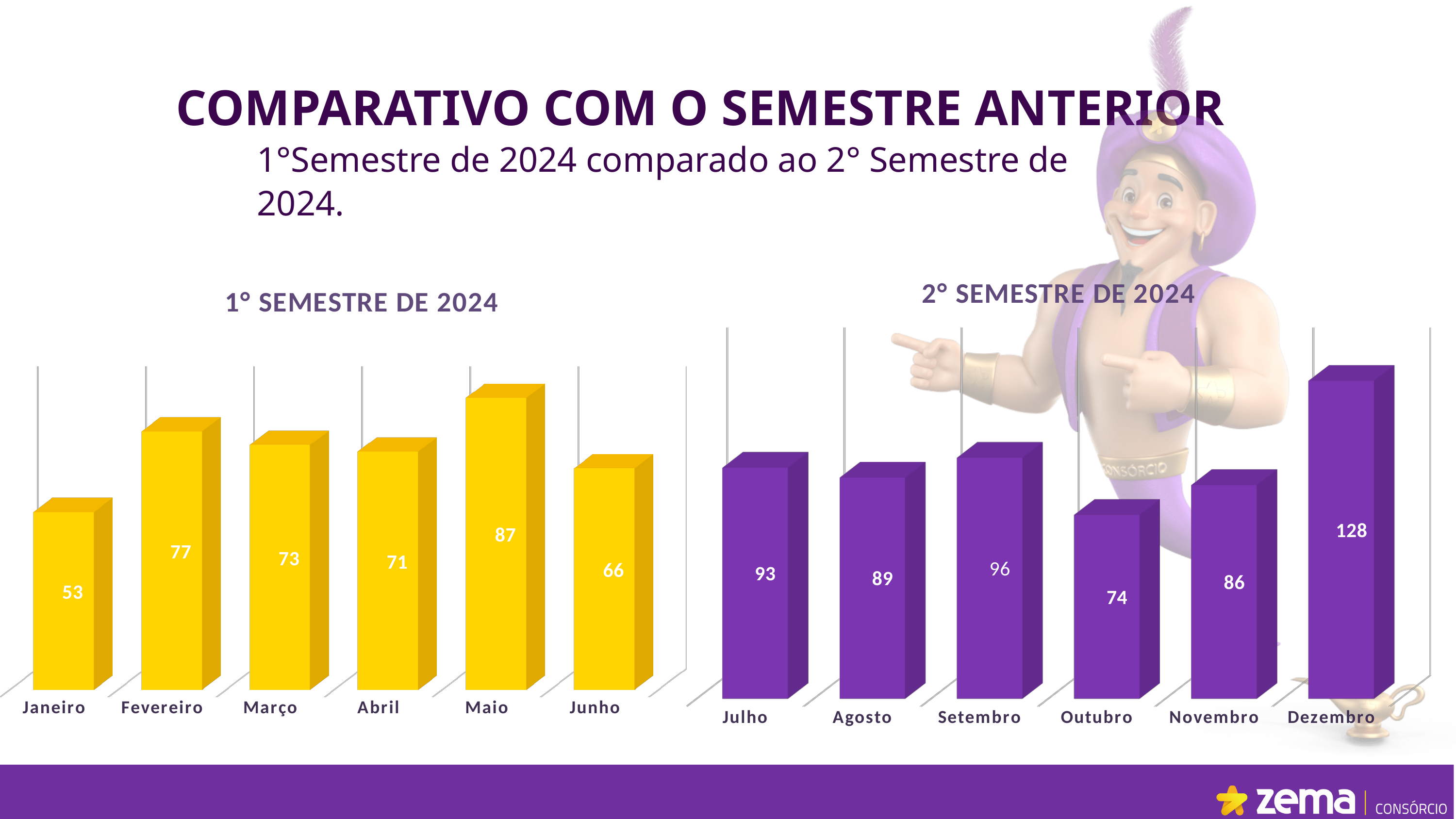
In the '2° SEMESTRE DE 2024' chart, which month has the highest value? Dezembro What kind of chart is the '1° SEMESTRE DE 2024' chart? Bar chart In the '1° SEMESTRE DE 2024' chart, what is the value for Maio? 87 In the '1° SEMESTRE DE 2024' chart, what is the value for Fevereiro? 77 In the '2° SEMESTRE DE 2024' chart, how many months are plotted? 6 In the '2° SEMESTRE DE 2024' chart, which is larger, the value for Julho or the value for Agosto? Julho In the '1° SEMESTRE DE 2024' chart, what is the difference between the values for Maio and Janeiro? 34 In the '2° SEMESTRE DE 2024' chart, what is the difference between the values for Dezembro and Outubro? 54 In the '2° SEMESTRE DE 2024' chart, what is the value for Outubro? 74 What colour are the bars in the '2° SEMESTRE DE 2024' chart? Purple In the '1° SEMESTRE DE 2024' chart, which month has the lowest value? Janeiro In the '1° SEMESTRE DE 2024' chart, how many months are plotted? 6